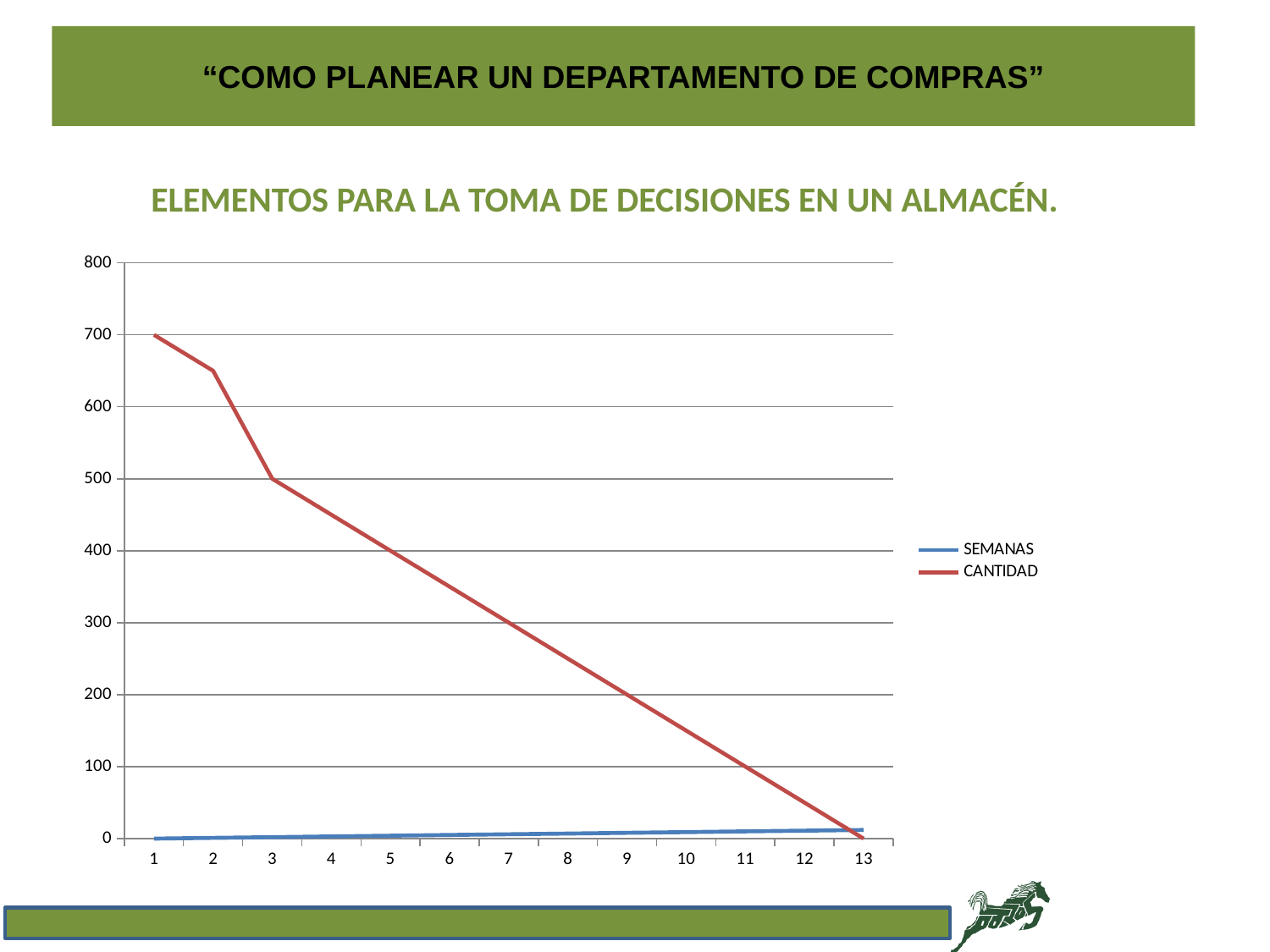
Is the value of CANTIDAD at x = 2 greater or less than 600? greater What kind of chart is shown on the slide? line chart What is the value of CANTIDAD at x = 3? 500 At which x value is CANTIDAD lowest? 13 Does CANTIDAD rise or fall as x increases from 1 to 13? fall What are the names of the two series in the legend? SEMANAS and CANTIDAD At x = 5, which series has the larger value, SEMANAS or CANTIDAD? CANTIDAD How many points are plotted along the x axis for each series? 13 Is the value of CANTIDAD at x = 8 greater or less than 300? less What is the value of CANTIDAD at x = 1? 700 At which x value is CANTIDAD highest? 1 How many series does the legend list? 2